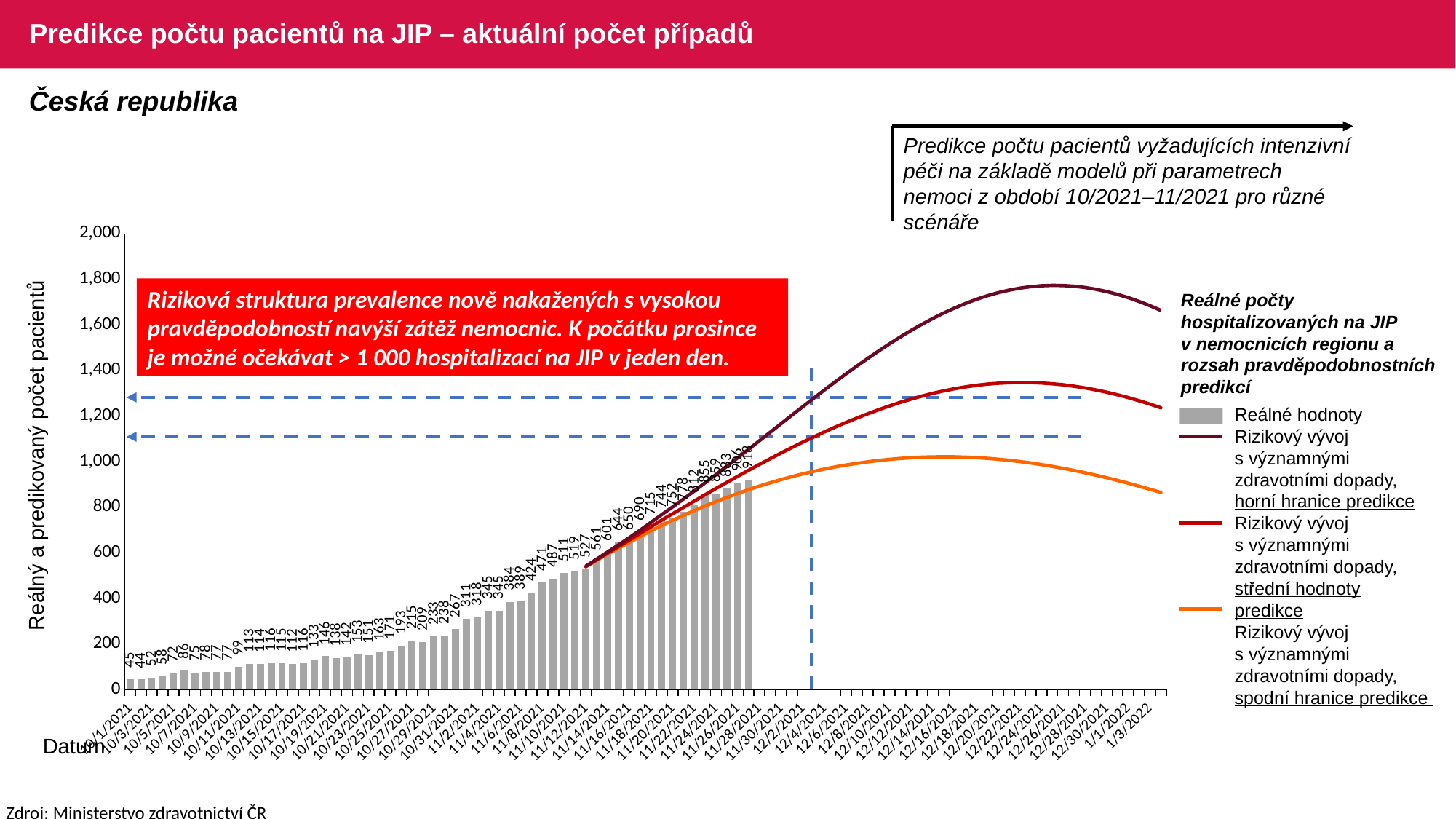
What is the label of the y axis? Reálný a predikovaný počet pacientů What kind of chart is shown on the slide? A combined bar and line chart Which series is shown as grey bars? Reálné hodnoty What is the highest value shown on the y axis? 2,000 How many series does the legend list? 4 Is the peak of the 'horní hranice predikce' line greater or less than 1,600? greater Is the peak of the 'střední hodnoty predikce' line greater or less than 1,400? less Do the bar values (Reálné hodnoty) rise or fall from 10/1/2021 to the end of November 2021? Rise Which prediction line reaches the lowest peak? Spodní hranice predikce Which prediction line reaches the highest peak? Horní hranice predikce Is the peak of the 'spodní hranice predikce' line greater or less than 1,200? less What is the value of the first bar, for 10/1/2021? 45